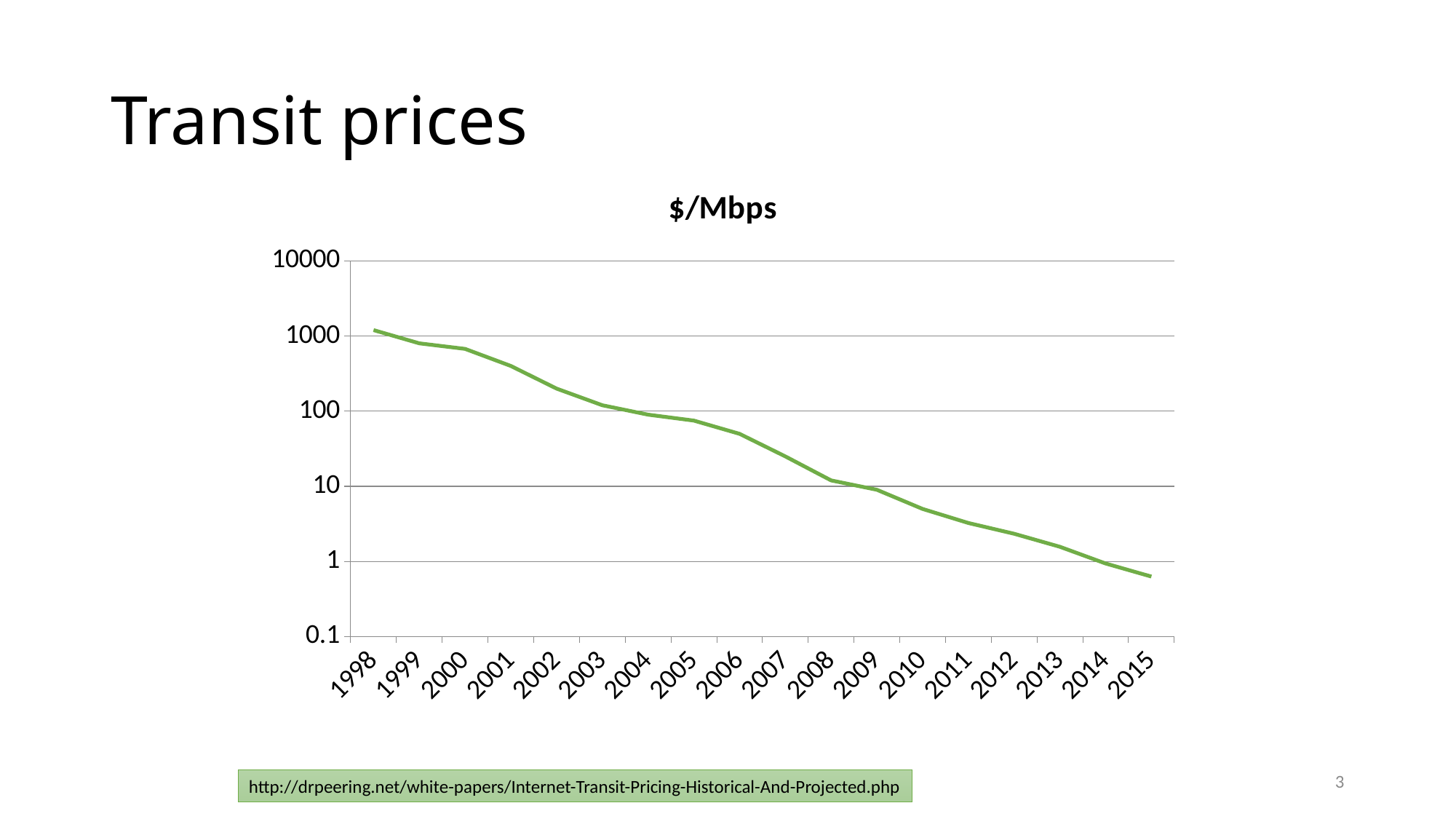
How many years are plotted along the x axis? 18 What is the title of the chart? $/Mbps Is the value for 1998 greater or less than 1000? greater Which year has the highest value? 1998 Which year has the lowest value? 2015 Is the value for 2010 greater or less than 10? less Is the value for 2005 greater or less than 100? less Do the values rise or fall from 1998 to 2015? fall Which year has the larger value, 2002 or 2006? 2002 What kind of chart is shown on the slide? line chart